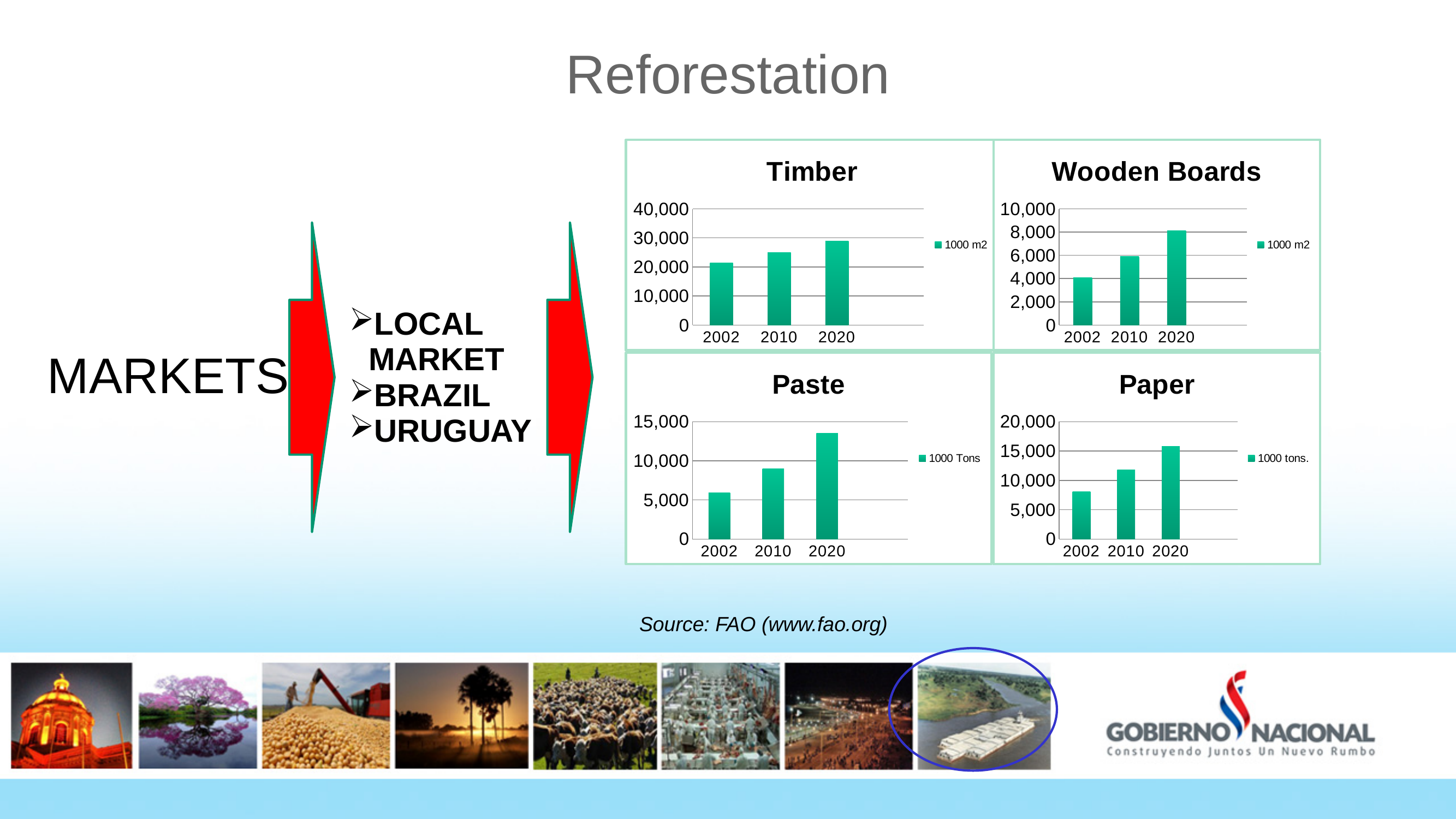
How many years are shown on the x axis of the Paste chart? 3 In the Paper chart, is the value for 2002 greater or less than 10,000? less What type of chart is the Wooden Boards chart? bar chart In the Paste chart, is the value for 2020 greater or less than 10,000? greater How many series does the legend of the Timber chart list? 1 What unit does the legend of the Paste chart show? 1000 Tons In the Paper chart, do the values rise or fall from 2002 to 2020? rise In the Wooden Boards chart, is the value for 2020 greater or less than 6,000? greater In the Paste chart, which is larger, the value for 2002 or the value for 2010? 2010 In the Wooden Boards chart, which year has the lowest value? 2002 In the Timber chart, which year has the highest value? 2020